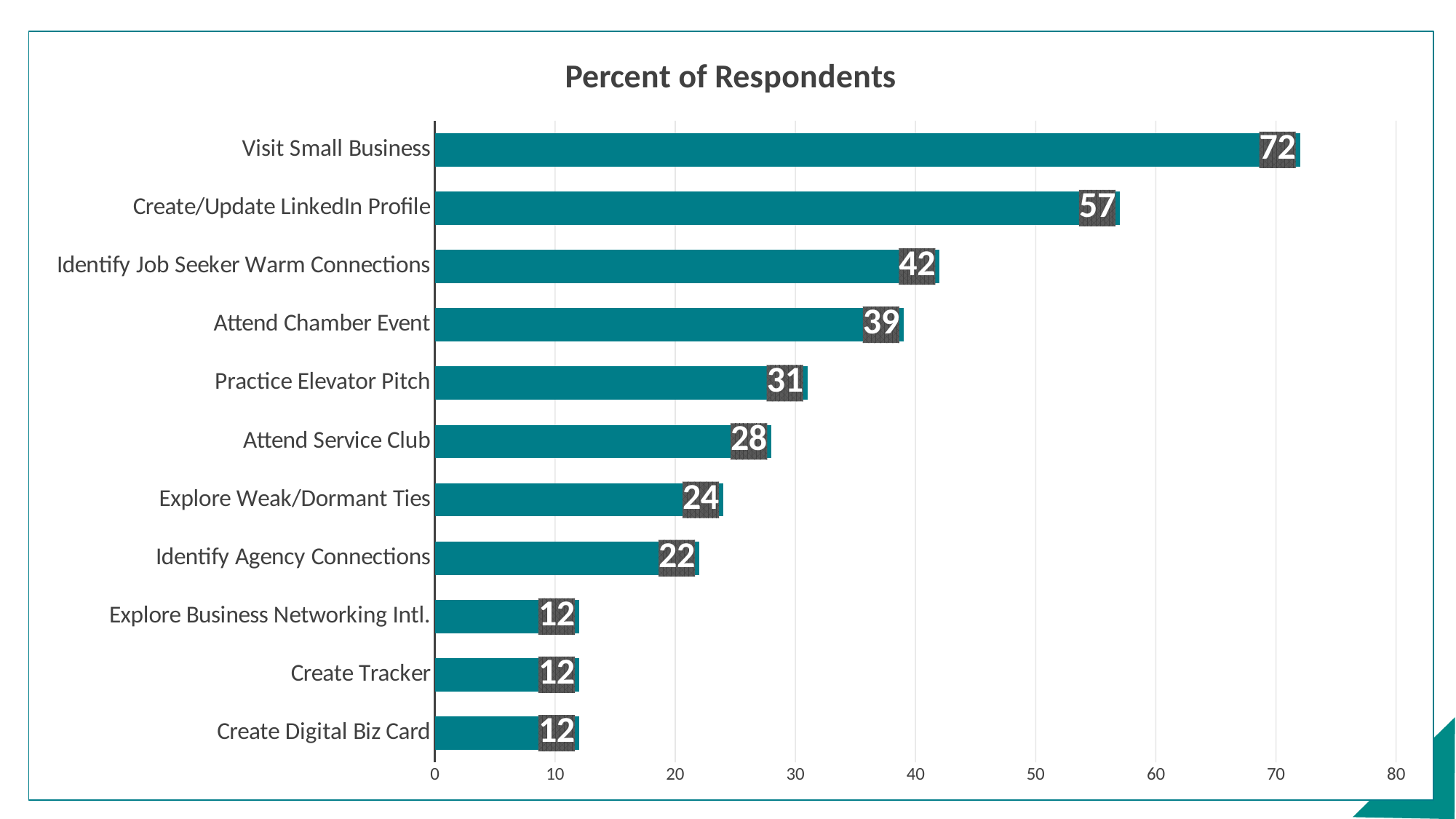
Is the value for Create/Update LinkedIn Profile greater or less than 50? greater What is the value for Explore Weak/Dormant Ties? 24 What is the value for Visit Small Business? 72 What is the title of the chart? Percent of Respondents Which category has the highest value? Visit Small Business How many categories are shown in the chart? 11 Which is larger, Identify Agency Connections or Create Tracker? Identify Agency Connections How many categories have a value of 12? 3 What is the difference between Create/Update LinkedIn Profile and Identify Job Seeker Warm Connections? 15 What is the difference between Practice Elevator Pitch and Attend Service Club? 3 What kind of chart is shown on the slide? bar chart What is the value for Attend Chamber Event? 39